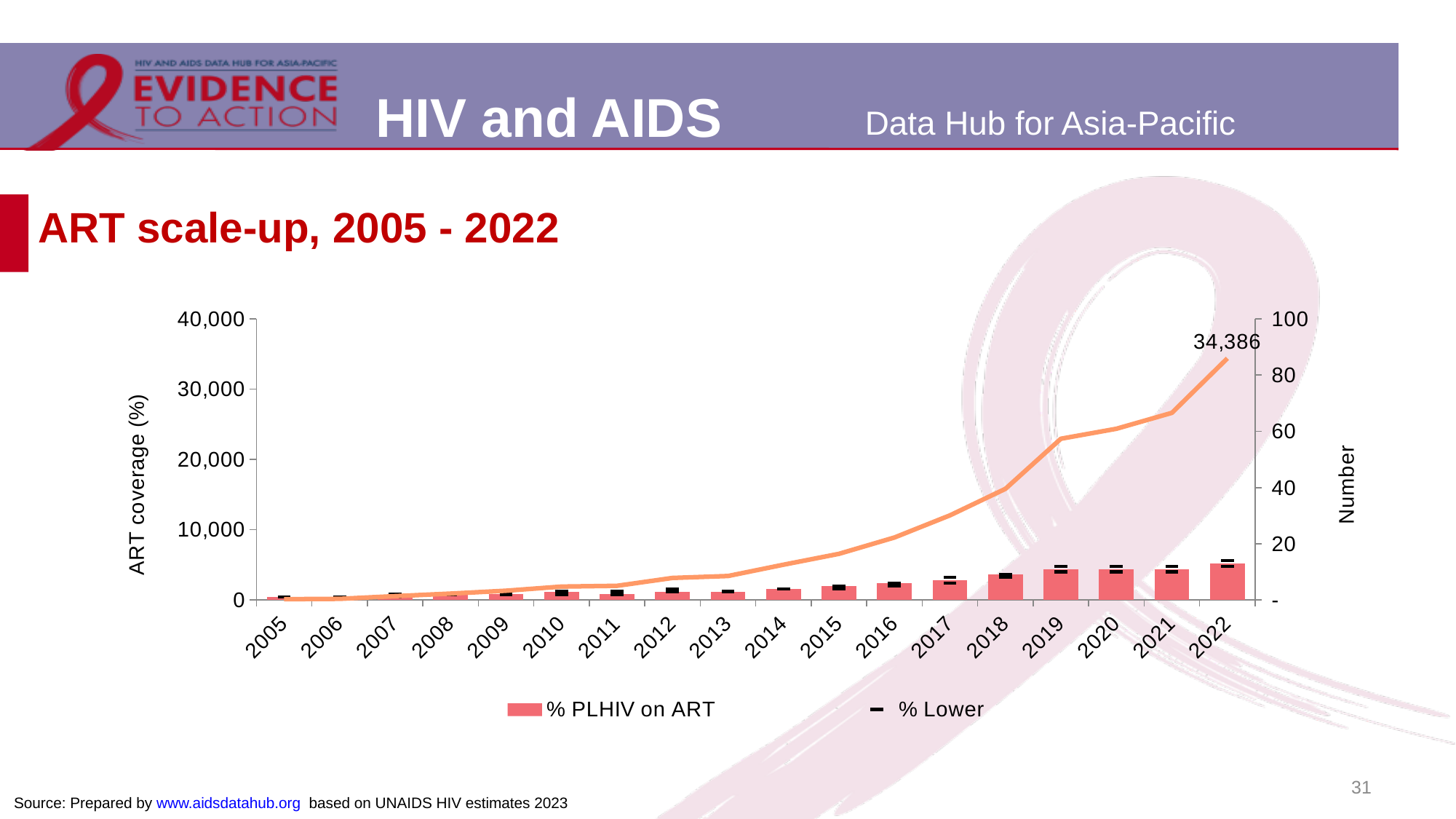
Is the value of the orange line in 2018 greater or less than 20,000 on the left axis? less Which year has the tallest % PLHIV on ART bar? 2022 What kind of chart is shown on the slide? Combined bar and line chart Is the value of the orange line in 2019 greater or less than 20,000 on the left axis? greater How many entries does the chart's legend list? 2 Is the value of the orange line in 2015 greater or less than 10,000 on the left axis? less Does the orange line rise or fall from 2005 to 2022? Rises Which year has the taller % PLHIV on ART bar, 2010 or 2018? 2018 What value is printed as a data label at the end of the orange line in 2022? 34,386 What is the title of the chart on the slide? ART scale-up, 2005 - 2022 How many years are shown along the x axis of the chart? 18